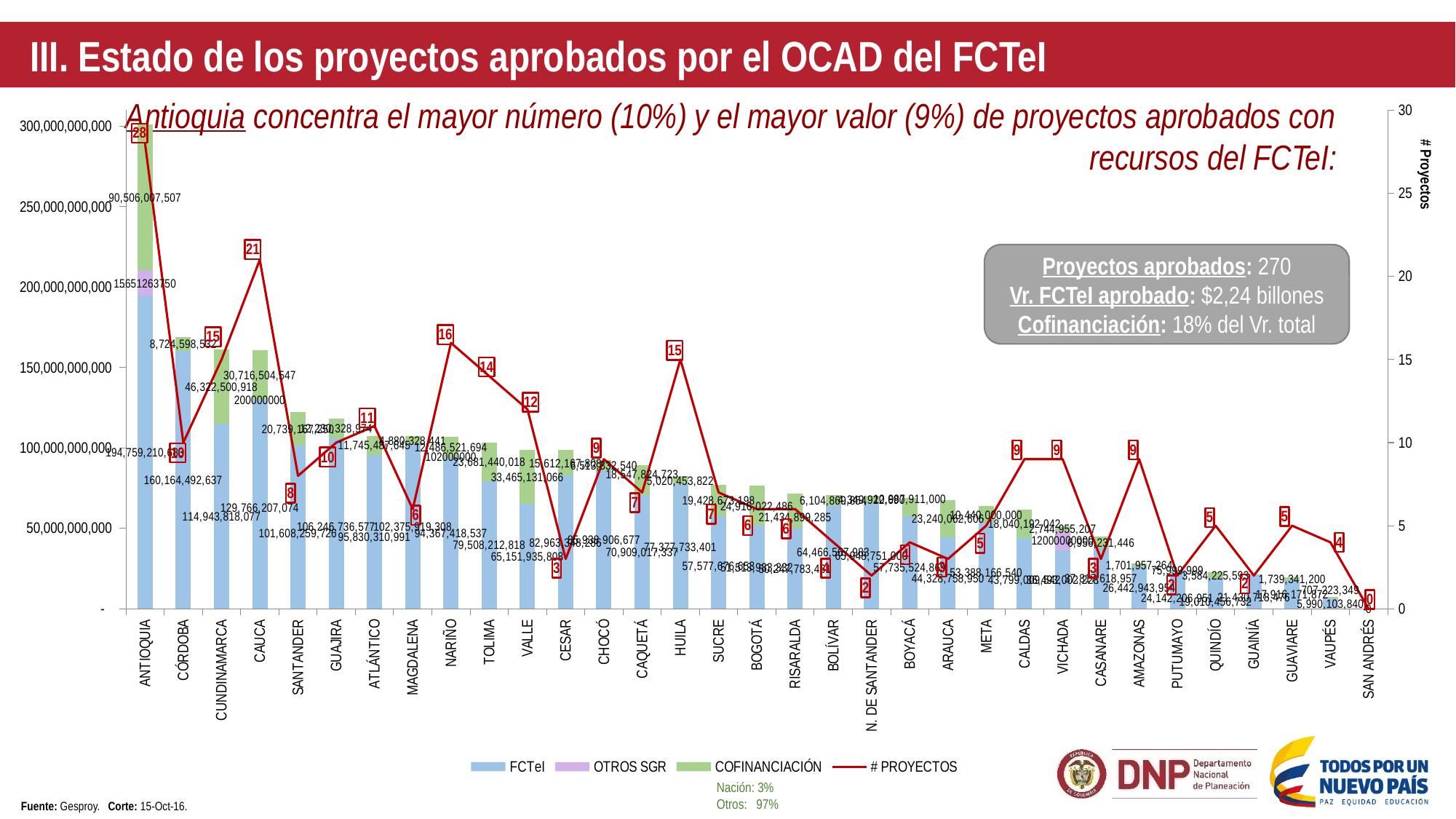
What is the FCTeI value labelled for ANTIOQUIA? 194,759,210,683 How many series does the legend list? 4 Which department has the highest number of projects on the # PROYECTOS line? ANTIOQUIA Which department has the lowest number of projects on the # PROYECTOS line? SAN ANDRÉS What is the difference in # PROYECTOS between ANTIOQUIA and CAUCA? 7 What kind of chart is shown on the slide? Combination stacked bar and line chart What is the FCTeI value labelled for CÓRDOBA? 160,164,492,637 What is the # PROYECTOS value shown for CAUCA? 21 How many projects (# PROYECTOS) does ANTIOQUIA have according to the red line label? 28 Which has more projects on the # PROYECTOS line, NARIÑO or HUILA? NARIÑO Is the total bar value for SAN ANDRÉS greater or less than 50,000,000,000? less How many departments (categories) are shown on the x axis? 33